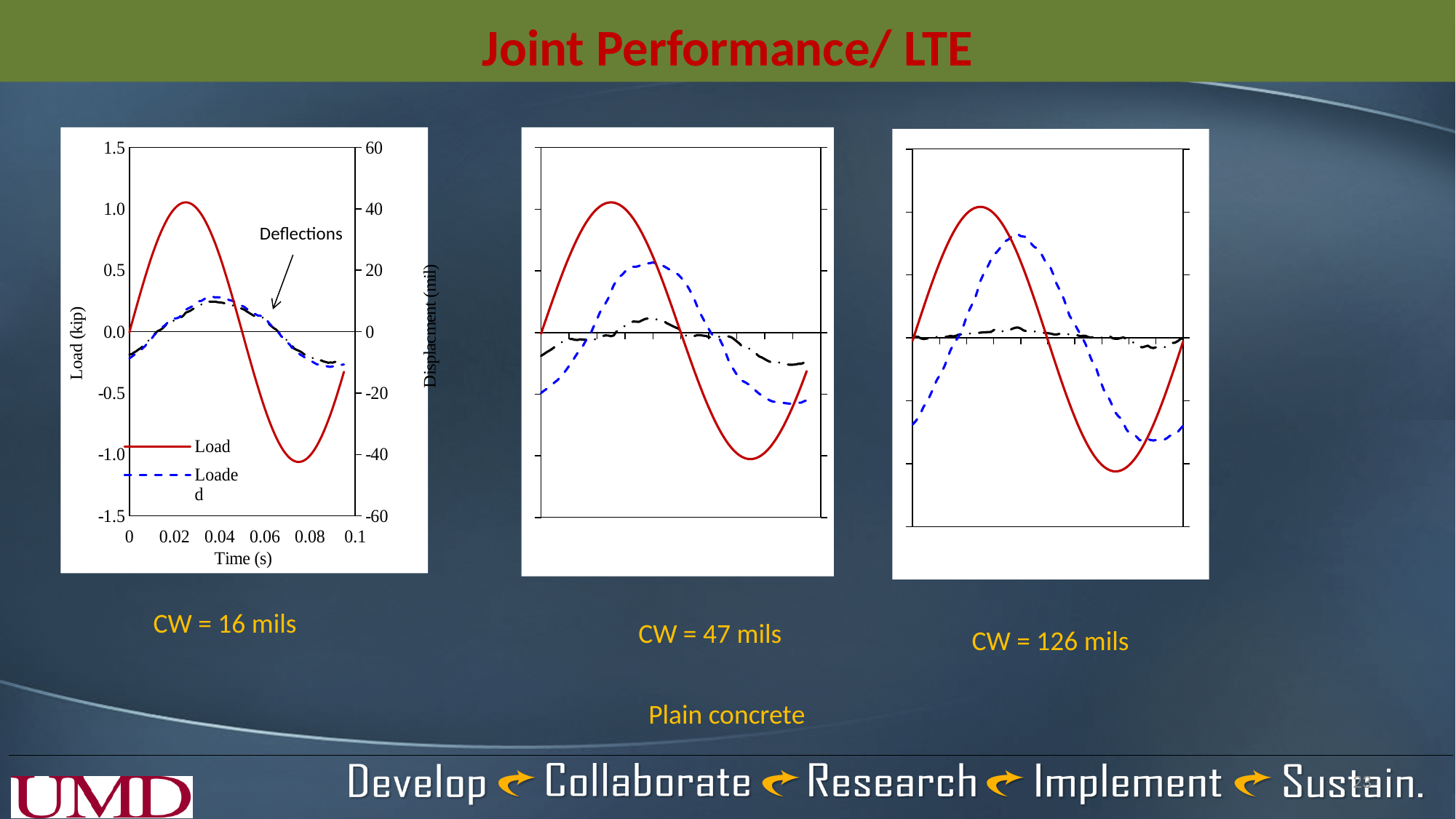
What is the label of the x axis of the left chart (CW = 16 mils)? Time (s) How many charts are shown on the slide? 3 In the left chart (CW = 16 mils), is the Load value at about 0.075 s greater or less than -0.5 kip? less What crack width (CW) is given for the rightmost chart? CW = 126 mils How many series does the legend of the left chart (CW = 16 mils) list? 2 In the left chart (CW = 16 mils), does the Load series rise or fall between 0.04 s and 0.06 s? fall What kind of chart is shown on the left of the slide (CW = 16 mils)? line chart In the left chart (CW = 16 mils), does the Load series rise or fall between 0 s and 0.02 s? rise In the left chart (CW = 16 mils), is the peak value of the Load series greater or less than 0.5 kip? greater